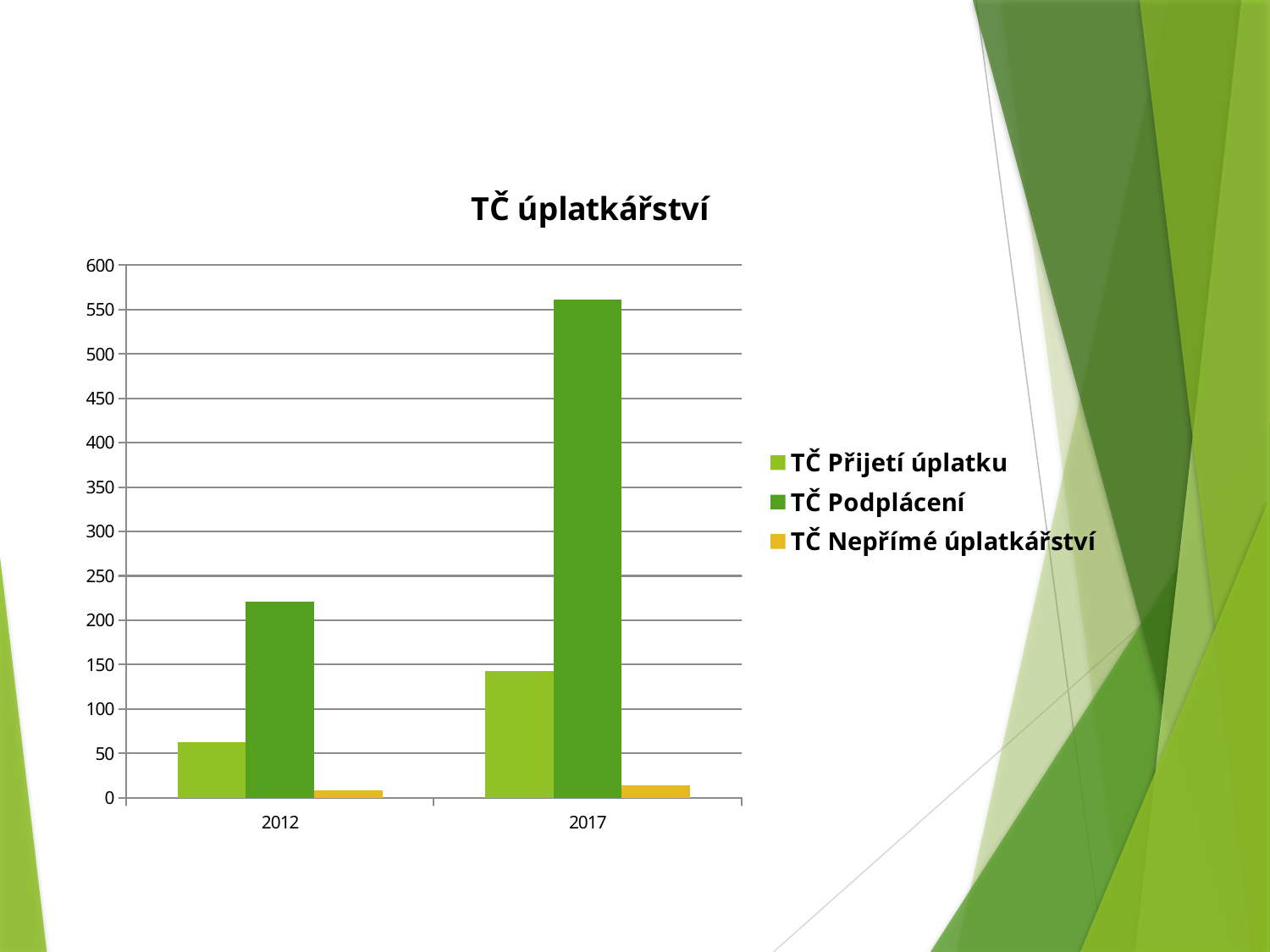
Which is larger: TČ Podplácení in 2012 or TČ Podplácení in 2017? 2017 Is the value for TČ Podplácení in 2012 greater or less than 200? greater Which series has the lowest value in 2012? TČ Nepřímé úplatkářství How many categories are shown on the x axis? 2 What is the title of the chart? TČ úplatkářství Is the value for TČ Přijetí úplatku in 2017 greater or less than 100? greater Is the value for TČ Podplácení in 2017 greater or less than 500? greater How many series does the legend list? 3 Which series has the highest value in 2017? TČ Podplácení Does the value for TČ Přijetí úplatku rise or fall from 2012 to 2017? rise What type of chart is shown on the slide? bar chart